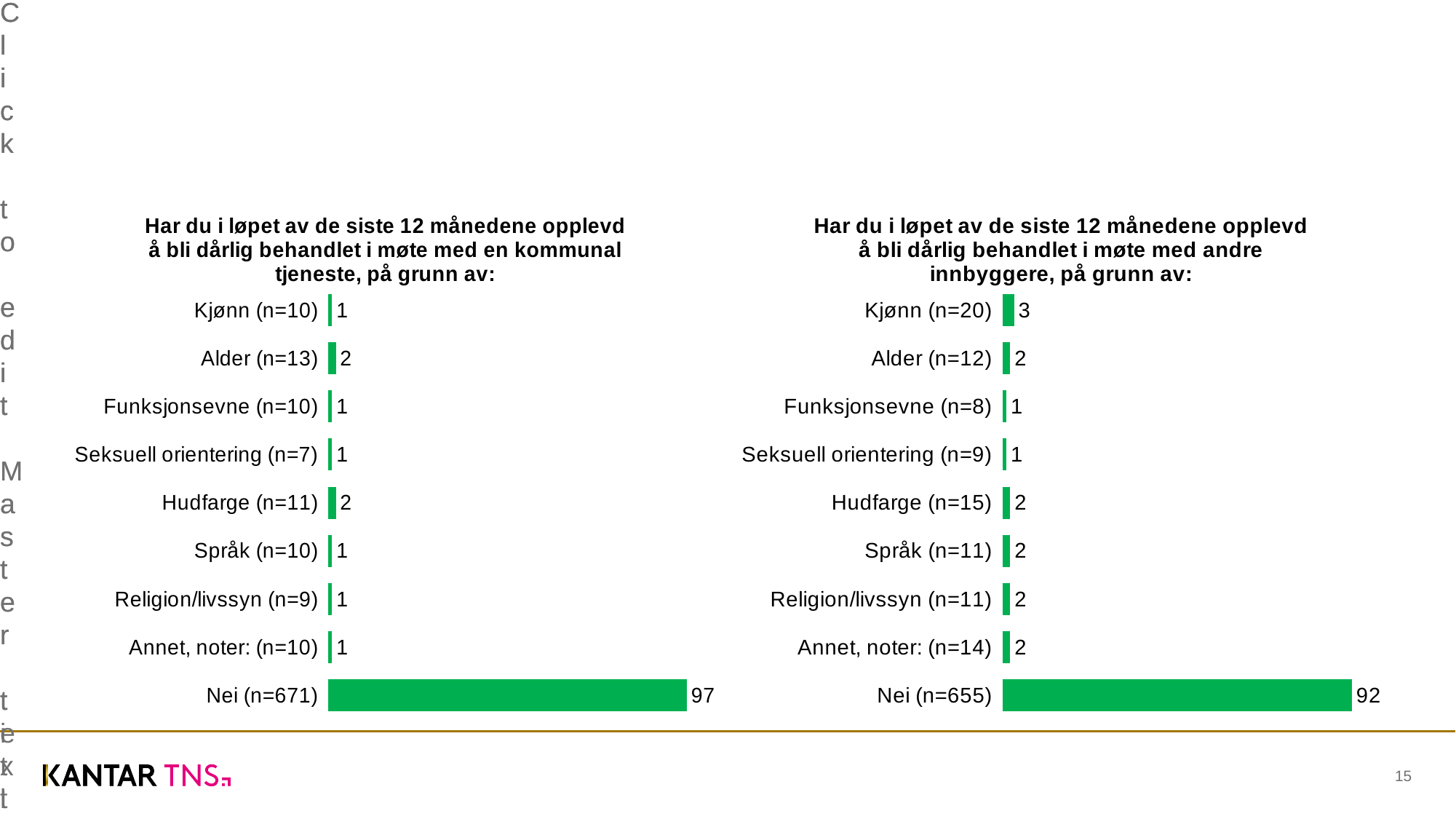
What colour are the bars in both charts? Green What type of chart is used on this slide? Bar chart In the right chart (andre innbyggere), what is the value for Funksjonsevne (n=8)? 1 In the right chart (andre innbyggere), what is the value for Kjønn (n=20)? 3 In the right chart (andre innbyggere), what is the value for Språk (n=11)? 2 Which is larger: the value for Kjønn in the left chart (kommunal tjeneste) or the value for Kjønn in the right chart (andre innbyggere)? Right chart (andre innbyggere) In the left chart (kommunal tjeneste), what is the difference between the values for Nei (n=671) and Alder (n=13)? 95 In the left chart (kommunal tjeneste), what is the value for Nei (n=671)? 97 In the right chart (andre innbyggere), which category has the highest value? Nei (n=655) In the left chart (kommunal tjeneste), what is the value for Hudfarge (n=11)? 2 How many categories are shown in the left chart (kommunal tjeneste)? 9 What is the difference between the Nei value in the left chart (97) and the Nei value in the right chart (92)? 5